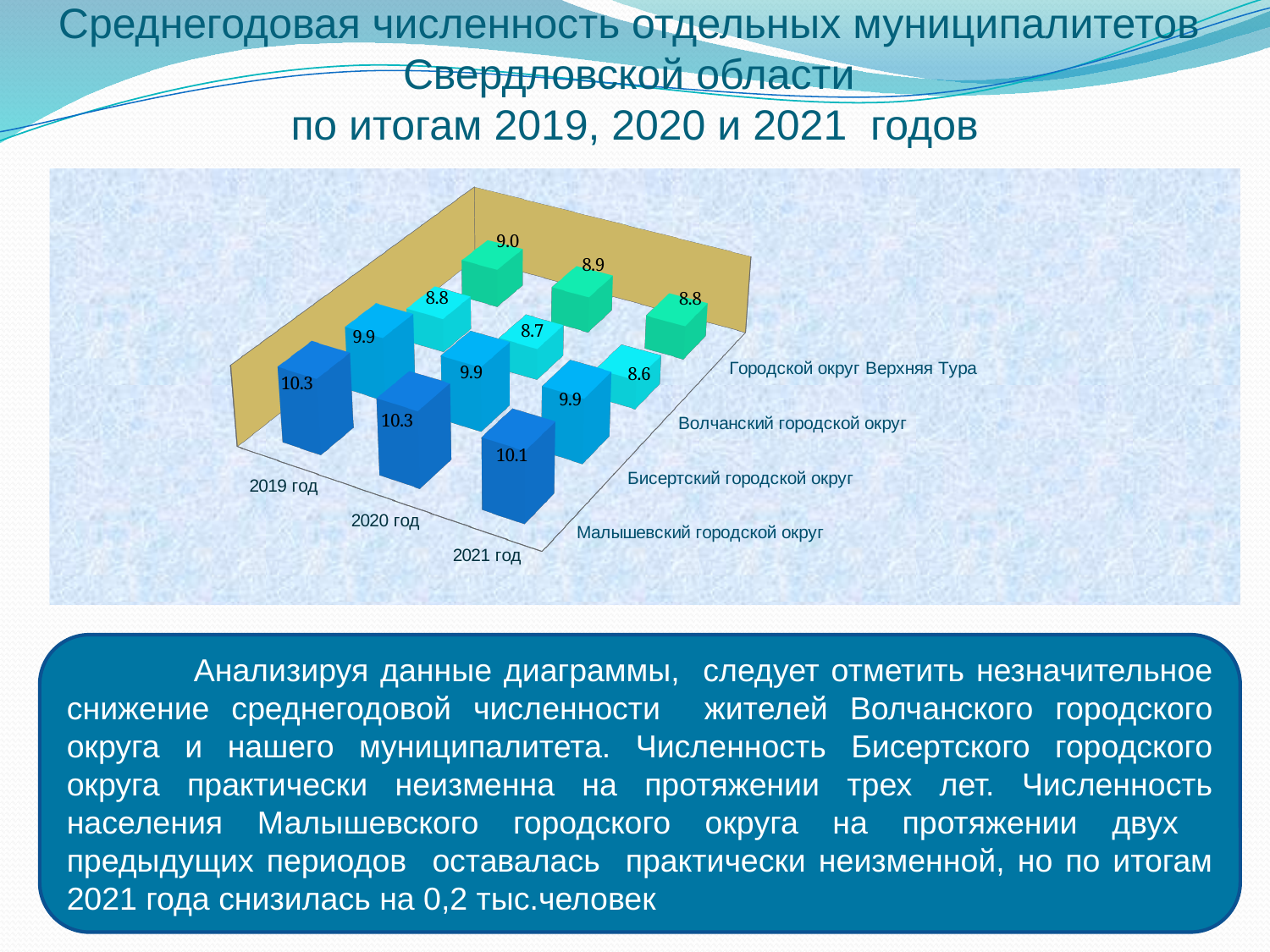
What is the value for Бисертский городской округ in 2020 год? 9.9 What kind of chart is shown on the slide? 3D bar chart Which municipality has the lowest value in 2021 год? Волчанский городской округ How many years are shown on the chart? 3 What is the value for Малышевский городской округ in 2021 год? 10.1 What is the difference between the values for Малышевский городской округ in 2020 год and 2021 год? 0.2 How many municipalities are shown on the chart? 4 What is the value for Волчанский городской округ in 2019 год? 8.8 Do the values for Волчанский городской округ rise or fall from 2019 год to 2021 год? fall Which is larger: the value for Городской округ Верхняя Тура in 2019 год or the value for Волчанский городской округ in 2019 год? Городской округ Верхняя Тура What is the value for Городской округ Верхняя Тура in 2020 год? 8.9 Which municipality has the highest value in 2019 год? Малышевский городской округ